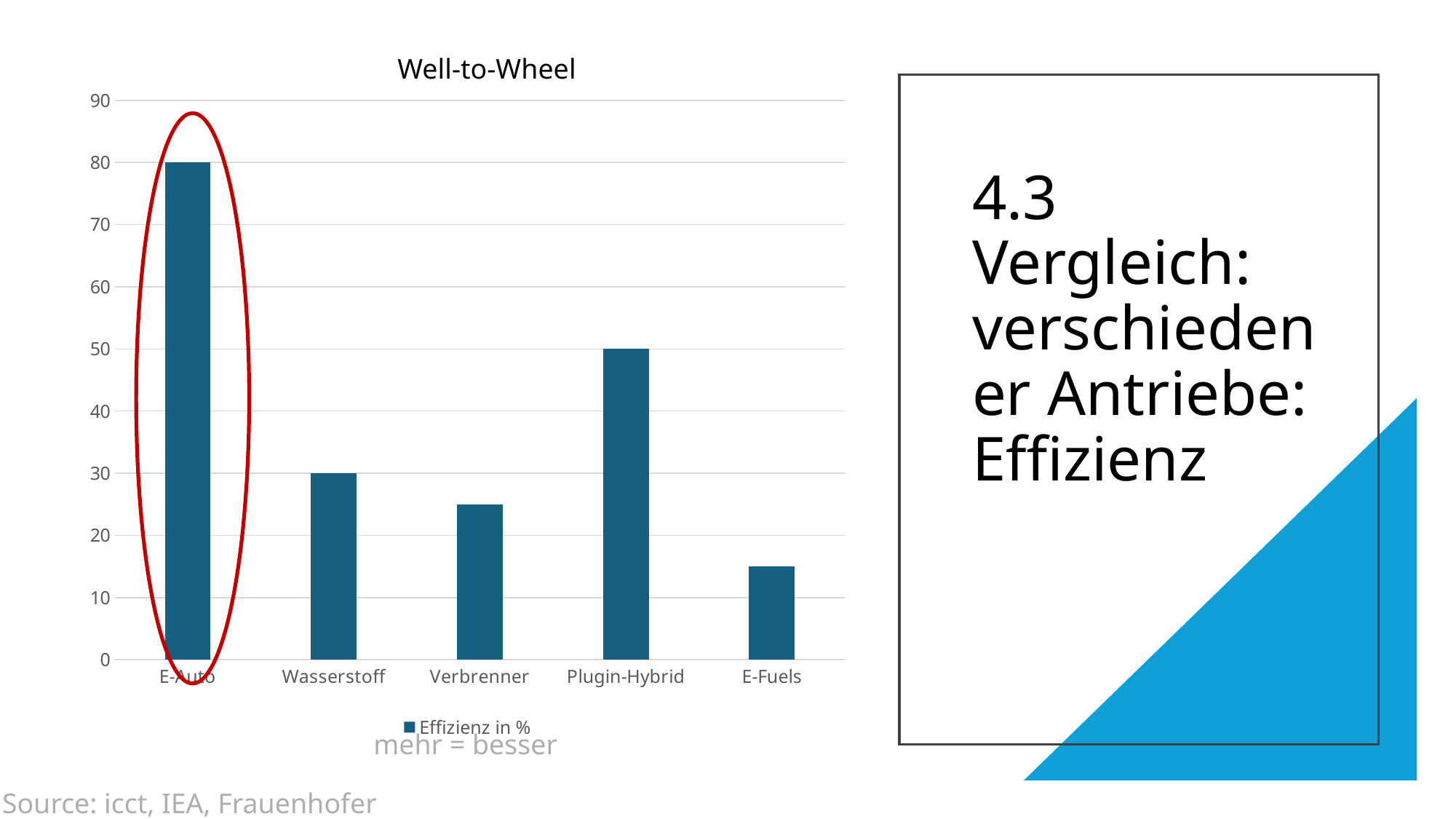
What is the difference between the values for E-Auto and Plugin-Hybrid? 30 Is the value for Verbrenner greater or less than 30? less Which category has the highest value? E-Auto Which category has the lowest value? E-Fuels What is the title of the chart? Well-to-Wheel What is the value for Wasserstoff? 30 Which is larger, the value for Wasserstoff or the value for E-Fuels? Wasserstoff What is the value for E-Auto? 80 What is the value for Plugin-Hybrid? 50 What type of chart is shown on the slide? bar chart How many categories are shown on the x axis of the chart? 5 How many series does the chart legend list? 1